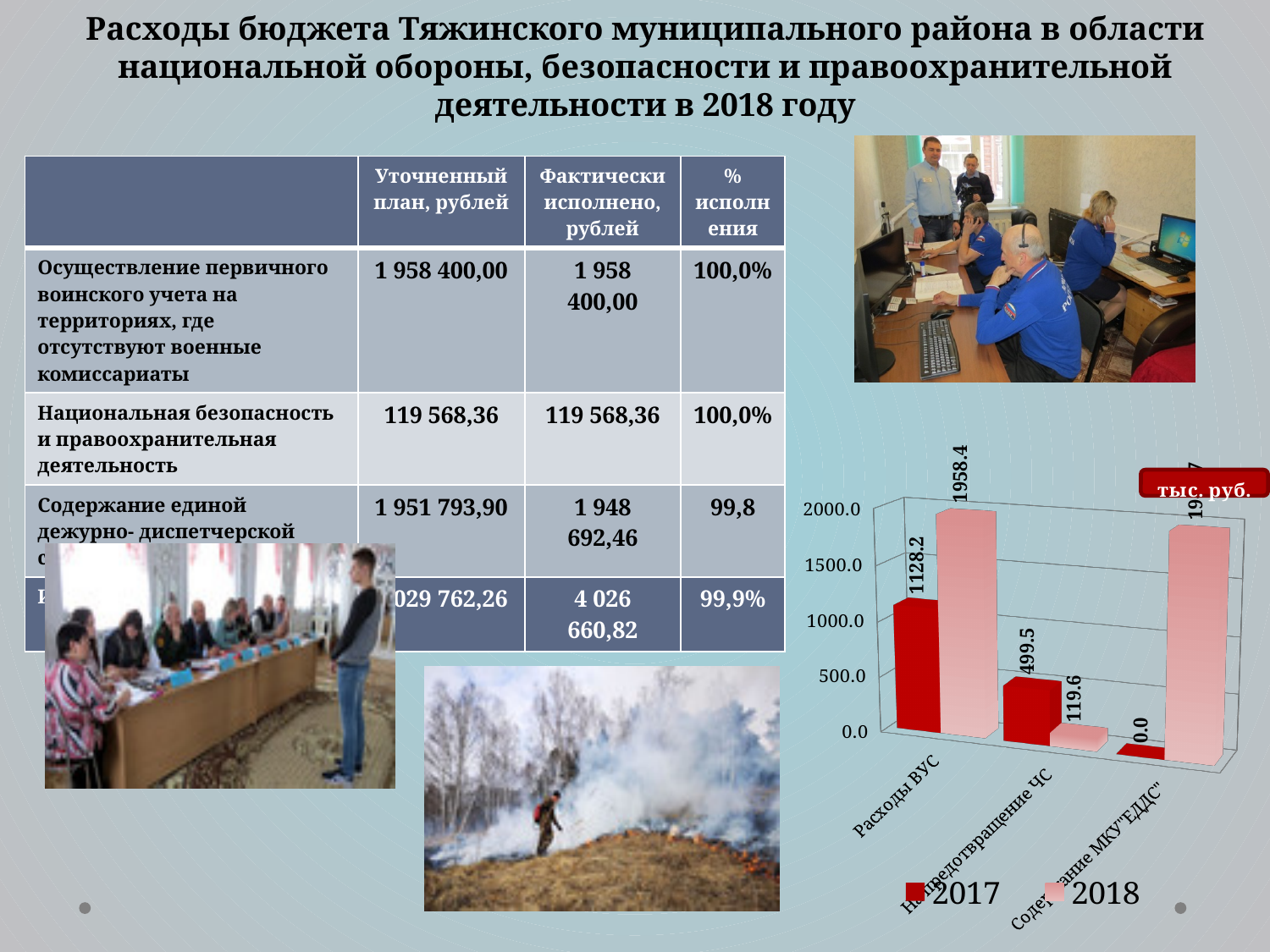
In the bar chart, what is the 2017 value for Расходы ВУС? 1128.2 How many categories are shown on the x axis of the bar chart? 3 What kind of chart is shown on the right side of the slide? bar chart In the bar chart, what is the 2017 value for На предотвращение ЧС? 499.5 In the bar chart, what is the 2018 value for Расходы ВУС? 1958.4 In the bar chart, is the 2018 value for Содержание МКУ "ЕДДС" greater or less than 1500? greater In the bar chart, what is the difference between the 2018 and 2017 values for Расходы ВУС? 830.2 In the bar chart, which year has the larger value for Расходы ВУС, 2017 or 2018? 2018 In the bar chart, what is the 2018 value for На предотвращение ЧС? 119.6 In the bar chart, which category has the highest 2017 value? Расходы ВУС How many series does the legend of the bar chart list? 2 What unit is indicated in the label at the top right of the bar chart? тыс. руб.